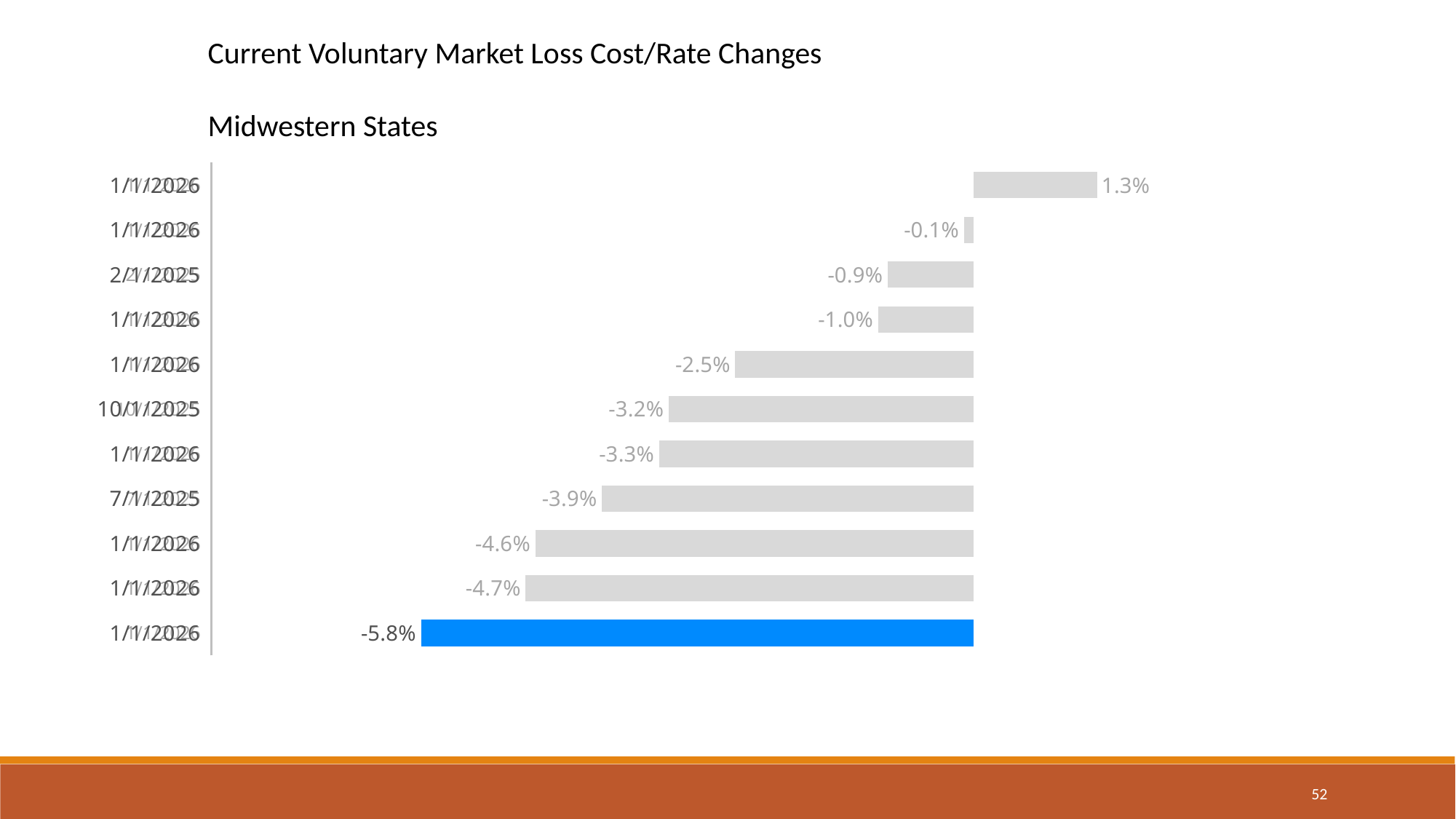
What is the highest value shown in the chart? 1.3% What is the difference between the highest value (1.3%) and the lowest value (-5.8%) in the chart? 7.1% Which is larger, the value on the second bar from the top (-0.1%) or the value on the third bar from the top (-0.9%)? -0.1% What is the value shown on the topmost bar of the chart? 1.3% What is the subtitle shown above the chart? Midwestern States What is the lowest value shown in the chart? -5.8% What is the difference between the two bottom bars, -4.7% and -5.8%? 1.1% How many bars in the chart have a positive value? 1 What is the value shown on the blue highlighted bar at the bottom of the chart? -5.8% What kind of chart is shown on the slide? bar chart How many bars are plotted in the chart? 11 What colour is the bar with the value -5.8%? blue